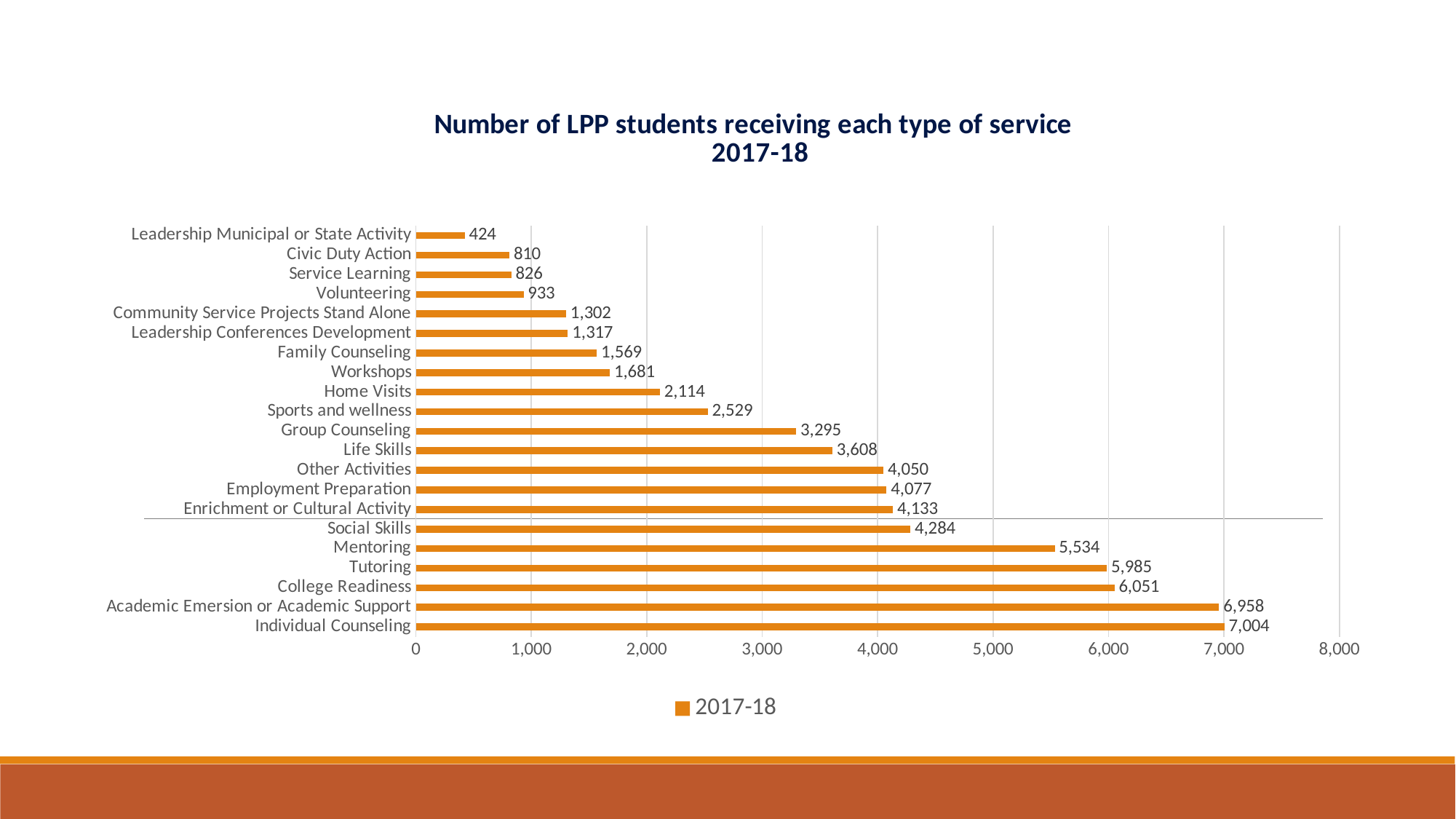
What is the difference between the values for Individual Counseling and Academic Emersion or Academic Support? 46 How many series does the legend list? 1 What is the value shown for Home Visits? 2,114 What is the difference between the values for Tutoring and Mentoring? 451 How many LPP students received Mentoring in 2017-18? 5,534 What kind of chart is shown on the slide? Bar chart Which has a larger value, Group Counseling or Sports and wellness? Group Counseling Which type of service has the lowest number of students? Leadership Municipal or State Activity What is the value shown for Community Service Projects Stand Alone? 1,302 Is the value for College Readiness greater or less than 6,000? greater Which type of service has the highest number of students? Individual Counseling How many types of service are shown in the chart? 21